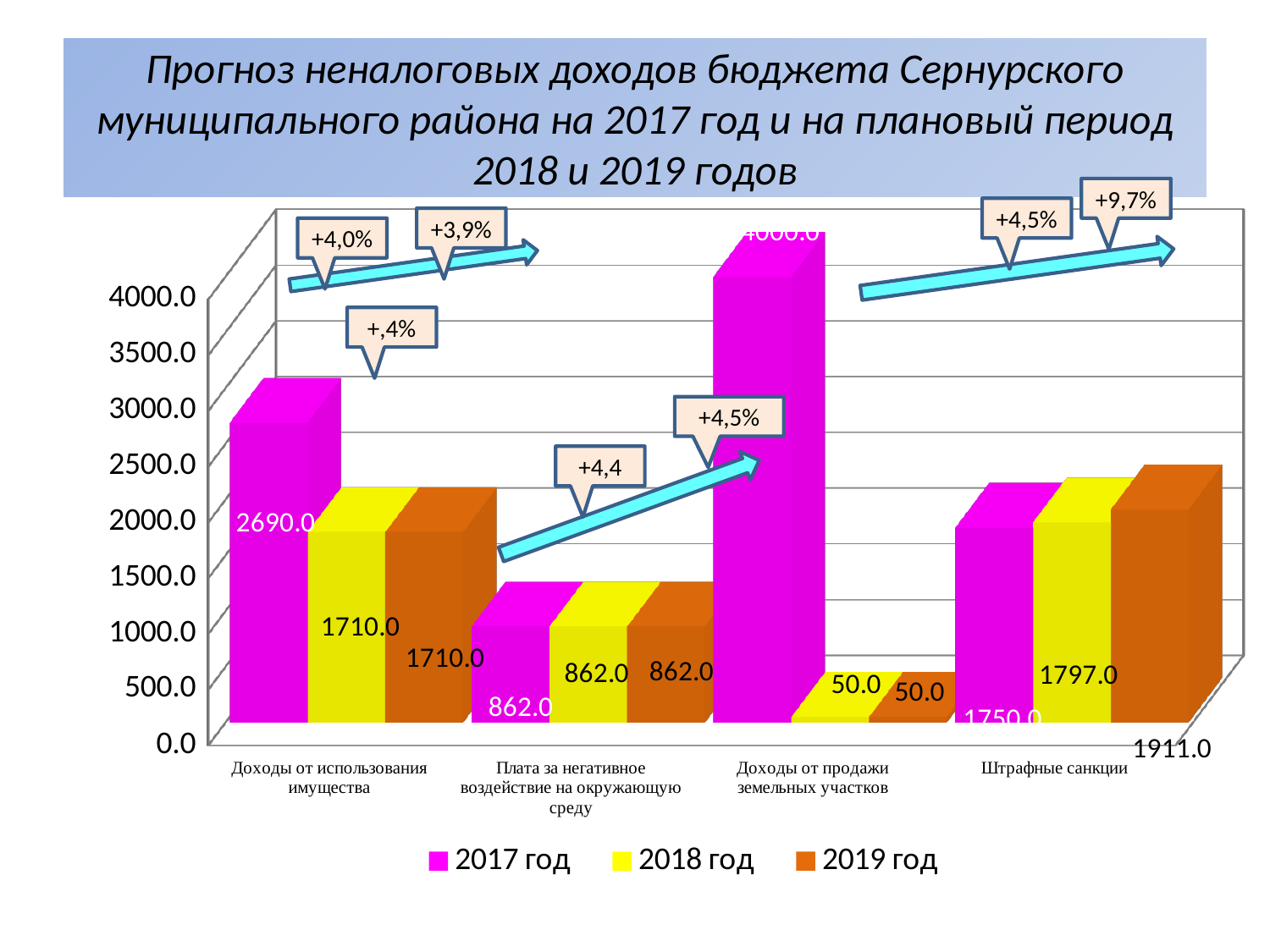
Is the 2017 год value for Доходы от продажи земельных участков greater or less than 3500? greater Do the values for Штрафные санкции rise or fall from 2017 год to 2019 год? rise What is the 2019 год value for Плата за негативное воздействие на окружающую среду? 862.0 How many series does the legend list? 3 What is the 2018 год value for Доходы от продажи земельных участков? 50.0 By how much does the 2019 год value for Штрафные санкции exceed the 2017 год value? 161.0 What is the 2017 год value for Доходы от использования имущества? 2690.0 What is the 2019 год value for Штрафные санкции? 1911.0 What is the 2018 год value for Штрафные санкции? 1797.0 Which category has the lowest 2018 год value? Доходы от продажи земельных участков What is the difference between the 2017 год and 2018 год values for Доходы от использования имущества? 980.0 Which is larger for 2018 год: Штрафные санкции or Доходы от использования имущества? Штрафные санкции